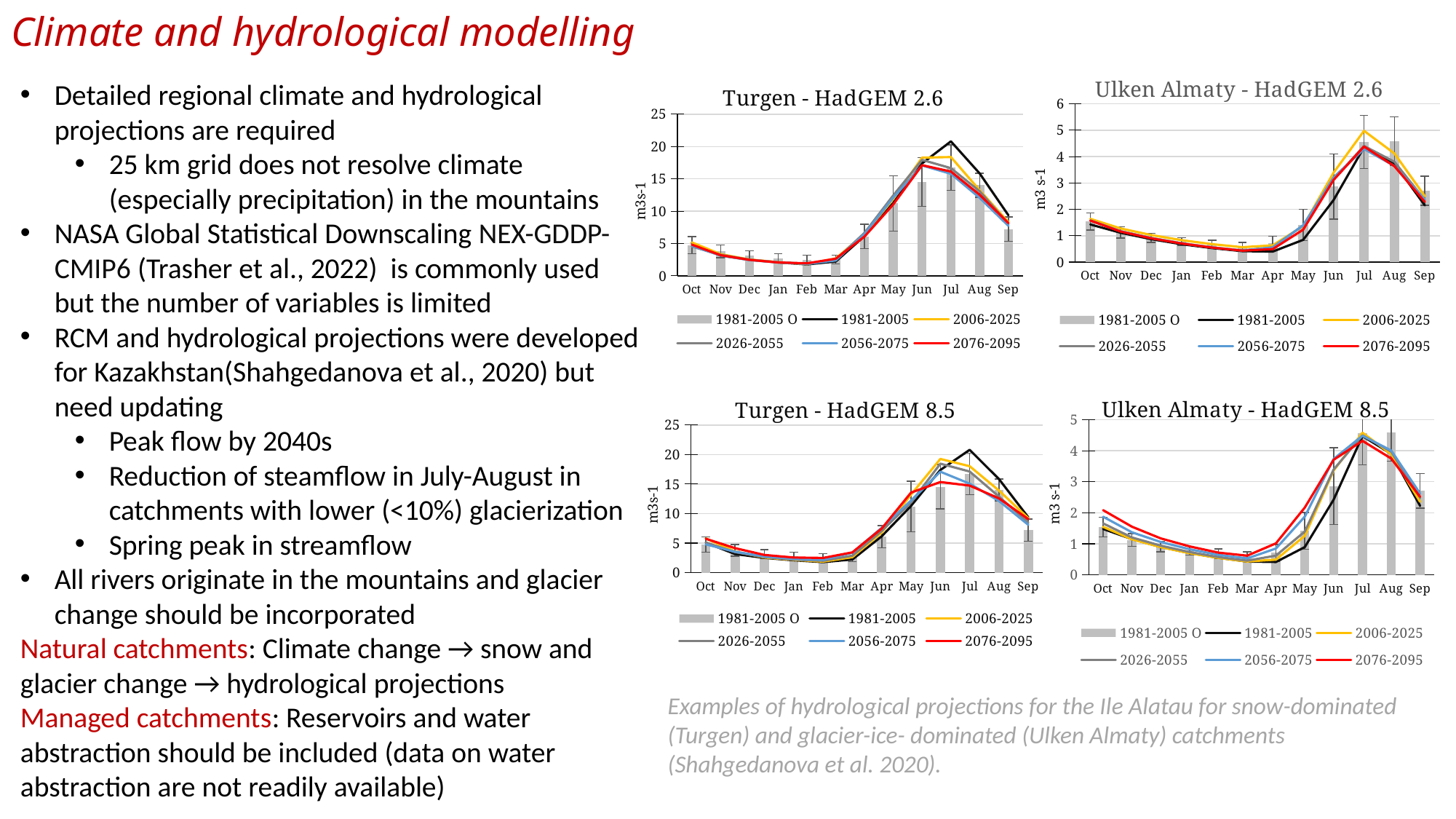
Which series is drawn in red in the 'Turgen - HadGEM 8.5' chart? 2076-2095 In the 'Ulken Almaty - HadGEM 8.5' chart, do the 1981-2005 O bars rise or fall from Mar to Jul? rise In the 'Turgen - HadGEM 8.5' chart, is the peak of the 2076-2095 line greater or less than 20? less In the 'Ulken Almaty - HadGEM 8.5' chart, is the 1981-2005 O bar for Aug greater or less than 4? greater What kind of chart is the 'Turgen - HadGEM 2.6' chart? A combined bar and line chart How many series does the legend of the 'Ulken Almaty - HadGEM 2.6' chart list? 6 In the 'Turgen - HadGEM 2.6' chart, is the 1981-2005 O bar for Jan greater or less than 5? less How many months are shown on the x axis of the 'Turgen - HadGEM 8.5' chart? 12 What is the title of the top-right chart on the slide? Ulken Almaty - HadGEM 2.6 In the 'Turgen - HadGEM 2.6' chart, which is larger, the 1981-2005 O bar for Jun or for Jan? Jun